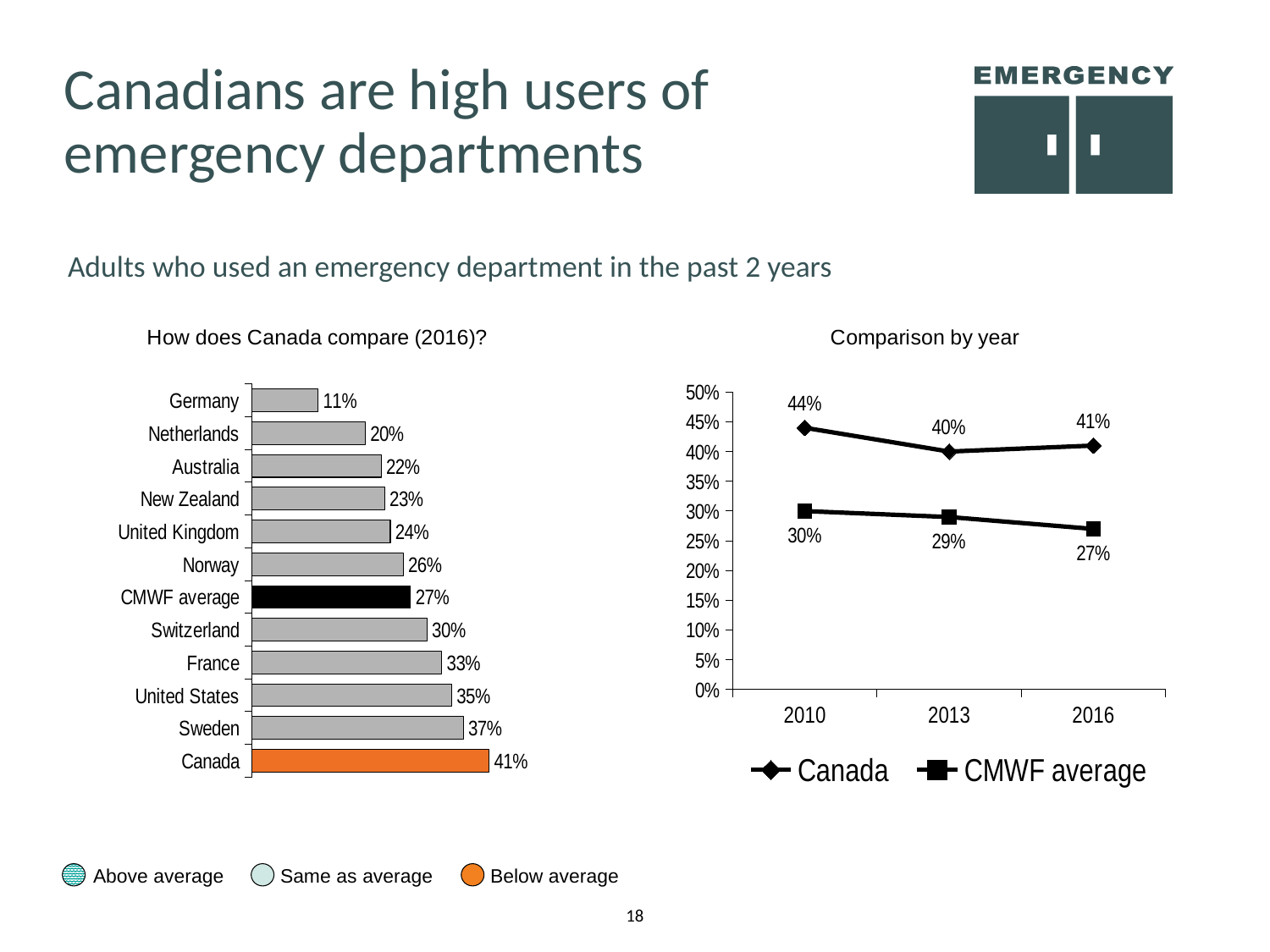
In the 'Comparison by year' chart, how many series does the legend list? 2 In the 'How does Canada compare (2016)?' chart, which category has the highest value? Canada How many categories are shown in the 'How does Canada compare (2016)?' chart? 12 In the 'Comparison by year' chart, what is the difference between Canada and the CMWF average in 2010? 14% In the 'How does Canada compare (2016)?' chart, which country has the lowest value? Germany In the 'How does Canada compare (2016)?' chart, what is the value for Sweden? 37% In the 'Comparison by year' chart, what is the value for Canada in 2013? 40% In the 'How does Canada compare (2016)?' chart, what is the difference between Canada and the CMWF average? 14% In the 'Comparison by year' chart, what is the value for the CMWF average in 2016? 27% In the 'How does Canada compare (2016)?' chart, which is larger, the value for France or the value for Switzerland? France In the 'Comparison by year' chart, does the CMWF average rise or fall from 2010 to 2016? Fall What kind of chart is the 'How does Canada compare (2016)?' chart? Bar chart